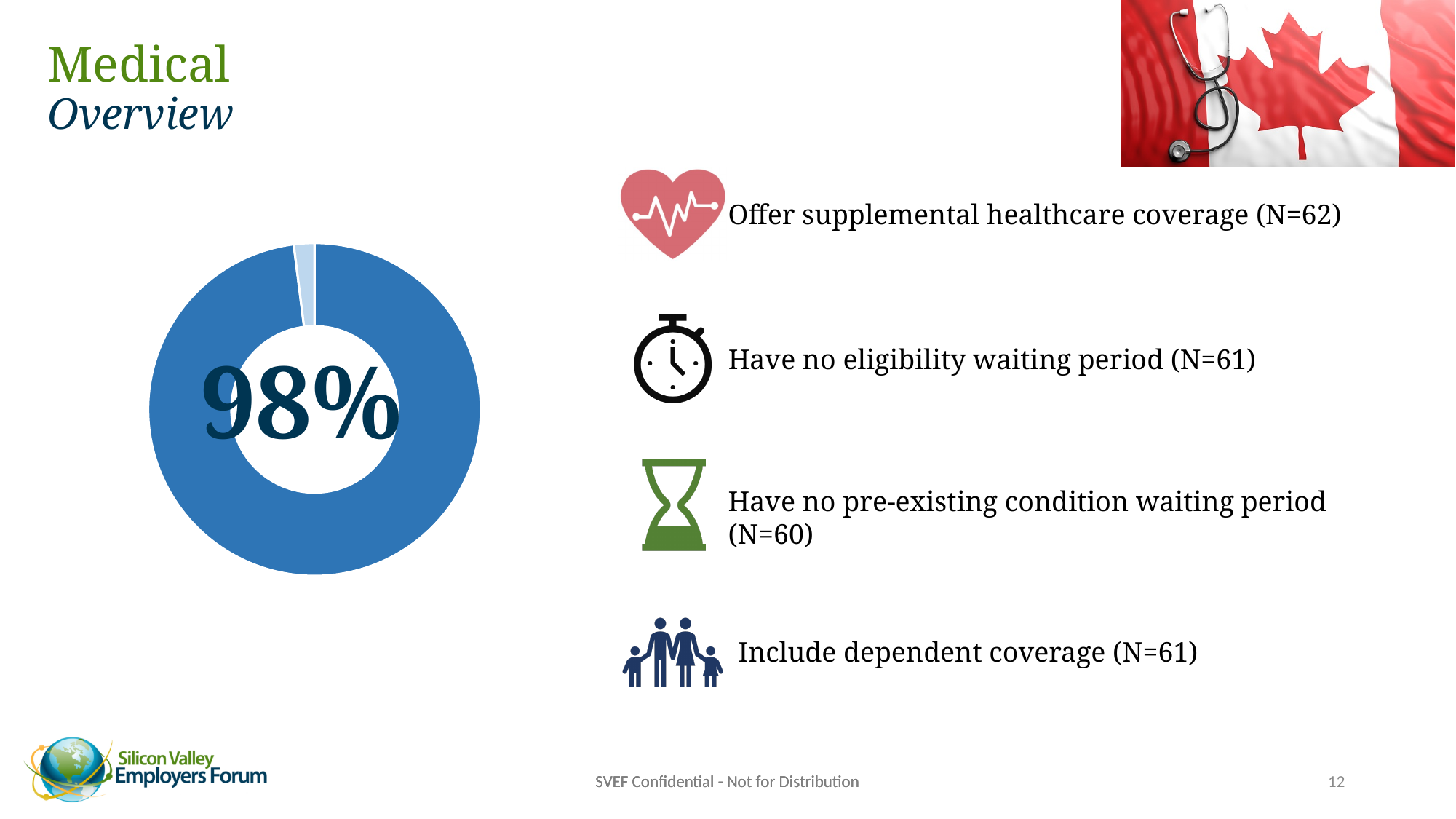
Is the value shown in the doughnut chart greater or less than 50%? greater How many slices does the doughnut chart have? 2 What percentage is printed in the centre of the doughnut chart? 98% Does the doughnut chart display a legend? No What share of the doughnut chart does the large dark blue slice represent? 98% What colour is the large slice of the doughnut chart? dark blue What kind of chart is shown on the left of the slide? doughnut chart Which slice of the doughnut chart is larger, the dark blue one or the light blue one? the dark blue one What share of the doughnut chart does the small light blue slice represent? 2%